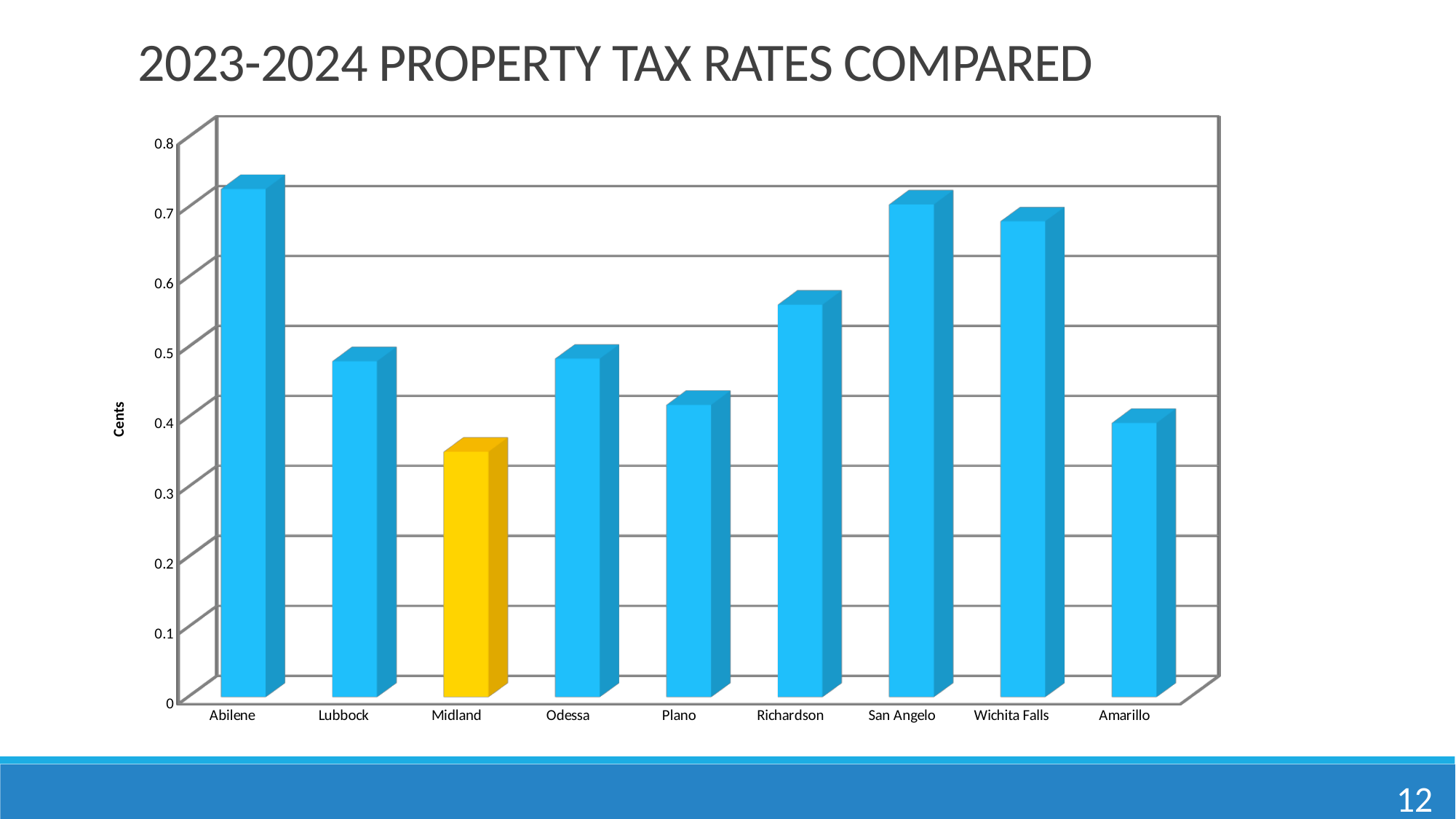
Which city has the lowest property tax rate in the chart? Midland Is the value for Richardson greater or less than 0.5? greater Which city's bar is coloured yellow instead of blue? Midland What kind of chart is shown on the slide? bar chart Is the value for Abilene greater or less than 0.7? greater Is the value for Amarillo greater or less than 0.5? less Which has the higher property tax rate, Abilene or Lubbock? Abilene How many cities are shown on the x axis of the chart? 9 What is the title of the chart on the slide? 2023-2024 PROPERTY TAX RATES COMPARED Which has the higher property tax rate, Richardson or Plano? Richardson